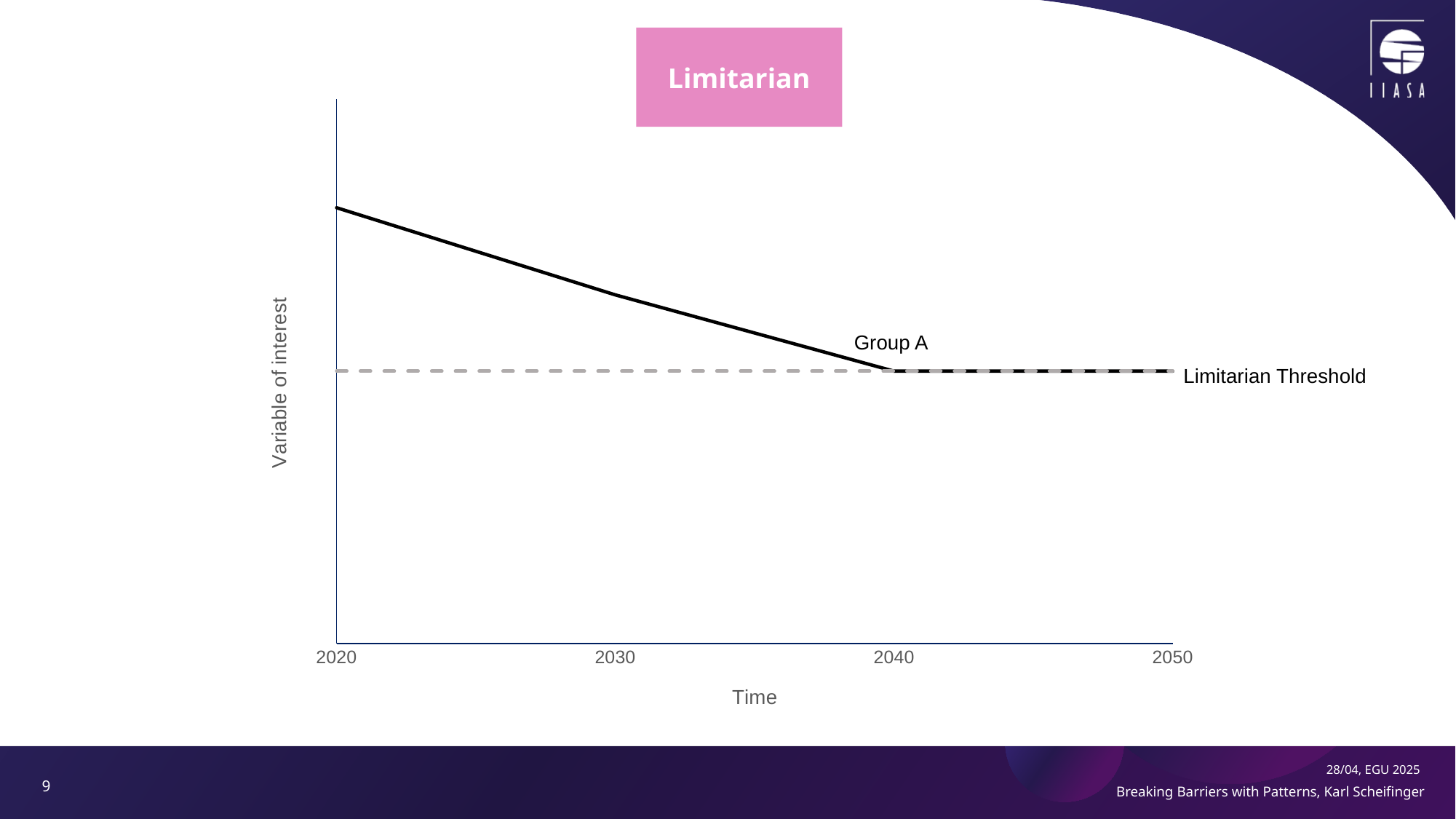
What is the first year shown on the x axis? 2020 In which year does the Group A line reach the Limitarian Threshold? 2040 What is the label of the y axis? Variable of interest Does the Group A line rise, fall or stay flat between 2040 and 2050? stay flat How many year labels are shown on the x axis? 4 What is the label of the x axis? Time How many labelled lines are plotted on the chart? 2 What kind of chart is shown on the slide? line chart Is the value for Group A higher in 2020 or in 2050? 2020 What is the name of the dashed horizontal line? Limitarian Threshold Does the Group A line rise or fall between 2020 and 2040? fall What is the title shown above the chart? Limitarian